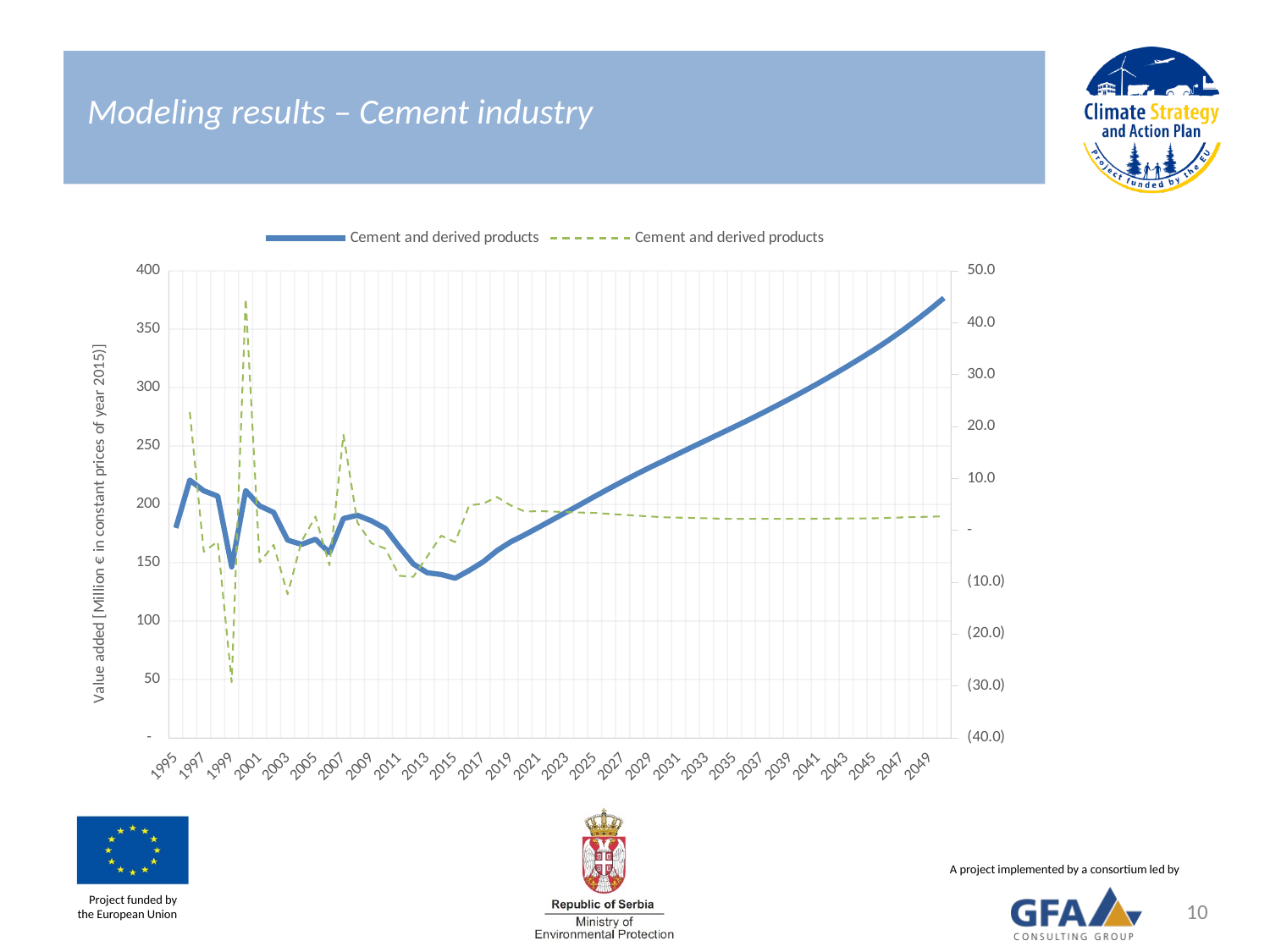
Is the value of the solid blue line in 1997 greater or less than 200? greater What label does the legend give to the solid blue line? Cement and derived products In which year does the solid blue line reach its highest value? 2050 How many year labels are shown on the x axis? 28 Is the value of the solid blue line in 2049 greater or less than 350? greater Is the value of the dashed green line at its 2000 peak greater or less than 40.0 on the right axis? greater Which year has the larger value on the solid blue line, 1995 or 2049? 2049 How many series does the legend list? 2 Does the solid blue line rise or fall between 2015 and 2049? rise What is the title of the left vertical axis? Value added [Million € in constant prices of year 2015)] What kind of chart is shown on the slide? line chart